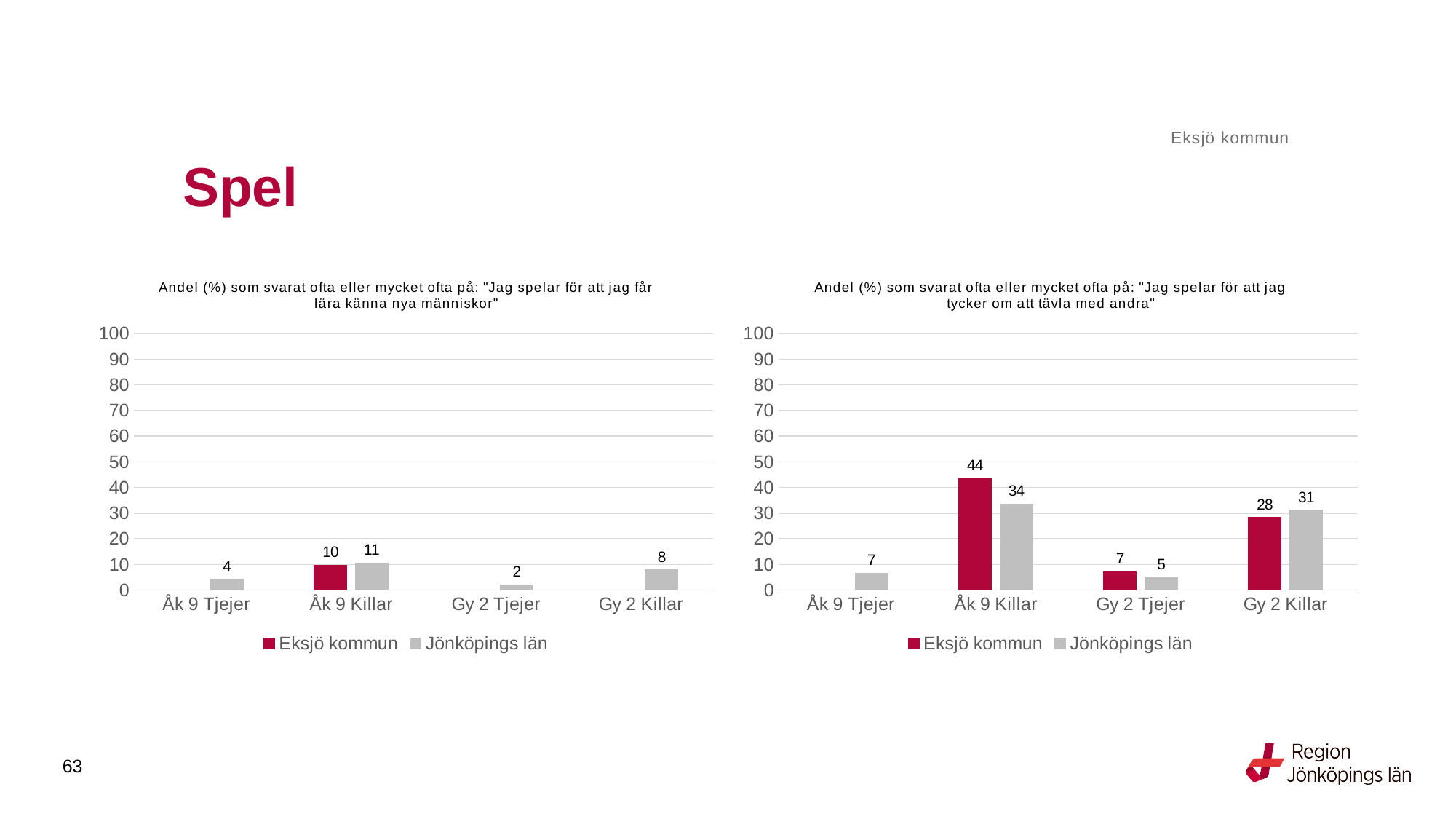
In the right chart ("tävla med andra"), what is the difference between Eksjö kommun and Jönköpings län for Åk 9 Killar? 10 In the right chart ("tävla med andra"), which is larger for Gy 2 Tjejer: Eksjö kommun or Jönköpings län? Eksjö kommun In the left chart ("lära känna nya människor"), what is the value for Jönköpings län for Gy 2 Tjejer? 2 How many series does the legend of the right chart list? 2 In the left chart ("lära känna nya människor"), what is the difference between the Jönköpings län values for Gy 2 Killar and Åk 9 Tjejer? 4 In the right chart ("tävla med andra"), what is the value for Eksjö kommun for Åk 9 Killar? 44 In the left chart ("lära känna nya människor"), which category has the lowest Jönköpings län value? Gy 2 Tjejer In the right chart ("tävla med andra"), what is the value for Jönköpings län for Gy 2 Killar? 31 In the left chart ("lära känna nya människor"), what is the value for Eksjö kommun for Åk 9 Killar? 10 What kind of chart is the left chart? Bar chart In the left chart ("lära känna nya människor"), which category has the highest Jönköpings län value? Åk 9 Killar In the right chart ("tävla med andra"), is the Eksjö kommun value for Åk 9 Killar greater or less than 40? greater